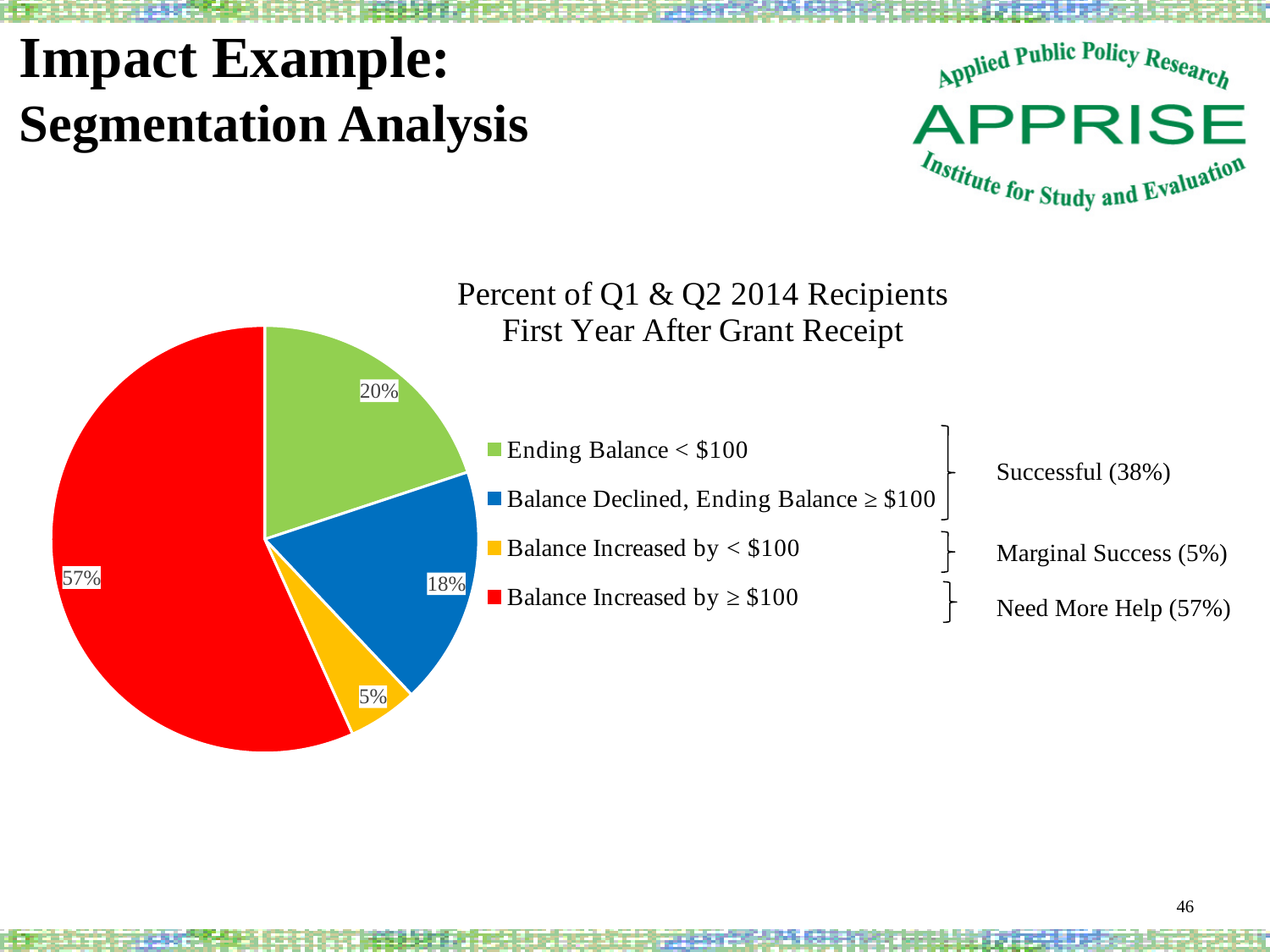
What is the title of the pie chart? Percent of Q1 & Q2 2014 Recipients First Year After Grant Receipt What percentage of recipients had an Ending Balance < $100? 20% What is the difference in percentage points between Balance Increased by ≥ $100 and Ending Balance < $100? 37 What percentage of recipients had Balance Increased by < $100? 5% Which category has the largest share of the pie? Balance Increased by ≥ $100 What percentage of recipients had Balance Increased by ≥ $100? 57% How many categories does the legend list? 4 Which category has the smallest share of the pie? Balance Increased by < $100 What colour is the slice for Balance Increased by ≥ $100? Red What kind of chart is shown on the slide? Pie chart What percentage of recipients had Balance Declined, Ending Balance ≥ $100? 18% Which is larger: the share for Ending Balance < $100 or the share for Balance Declined, Ending Balance ≥ $100? Ending Balance < $100